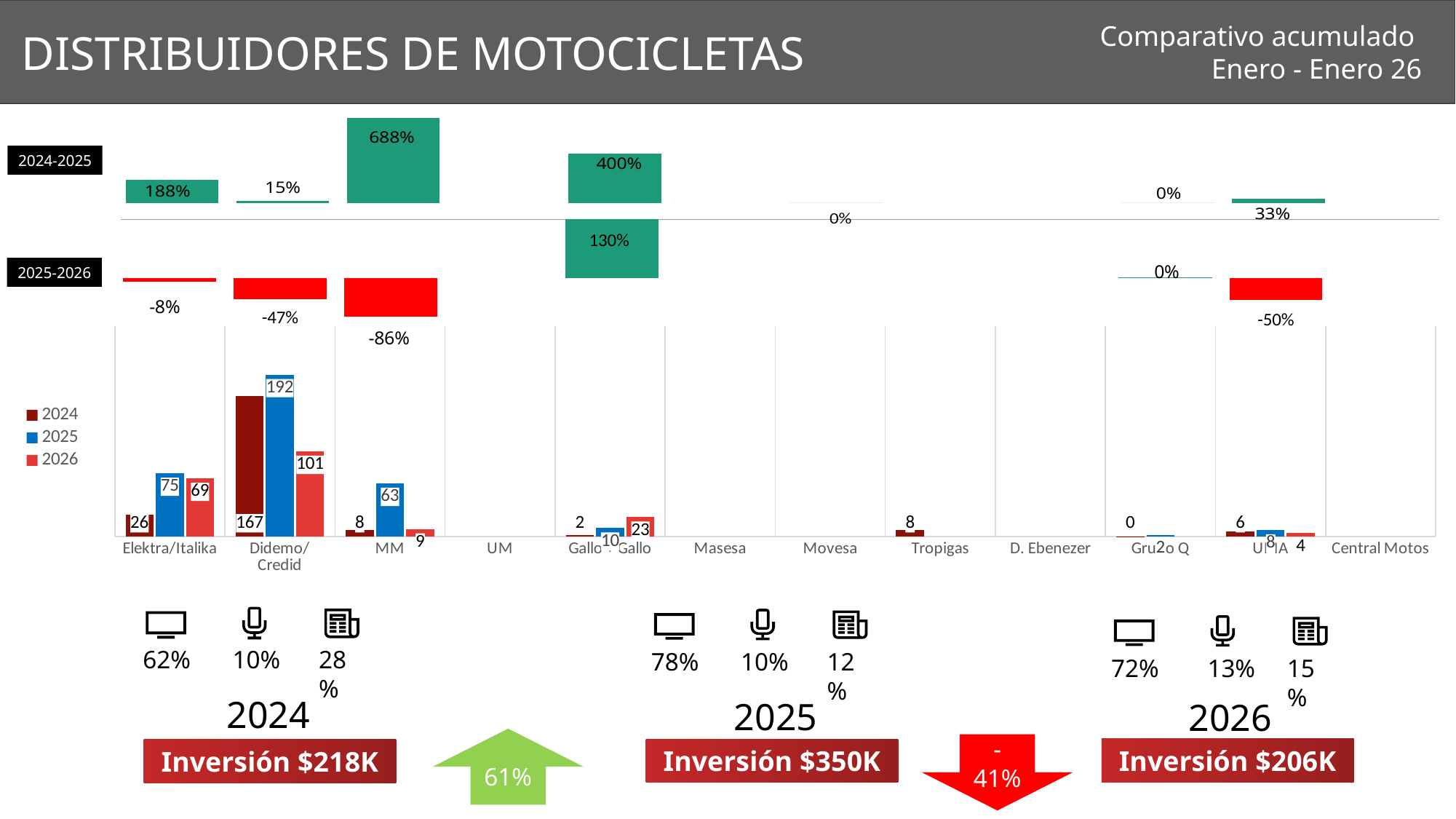
In the bar chart, what is the 2025 value for Didemo/Credid? 192 In the bar chart, what is the 2026 value for Elektra/Italika? 69 In the bar chart, what is the difference between the 2025 and 2026 values for Didemo/Credid? 91 In the bar chart, what is the difference between the 2025 and 2024 values for MM? 55 How many series does the legend of the bar chart list? 3 In the bar chart, which is larger for Elektra/Italika: the 2025 value or the 2026 value? 2025 In the bar chart, what is the 2026 value for Gallo·Gallo? 23 How many distributor categories are shown on the x axis of the bar chart? 12 In the 2025-2026 change chart, what is the percentage shown for Didemo/Credid? -47% What kind of chart is used to show the 2024, 2025 and 2026 values by distributor? bar chart In the 2024-2025 change chart at the top, what is the percentage shown for MM? 688% In the bar chart, which distributor has the highest 2025 value? Didemo/Credid